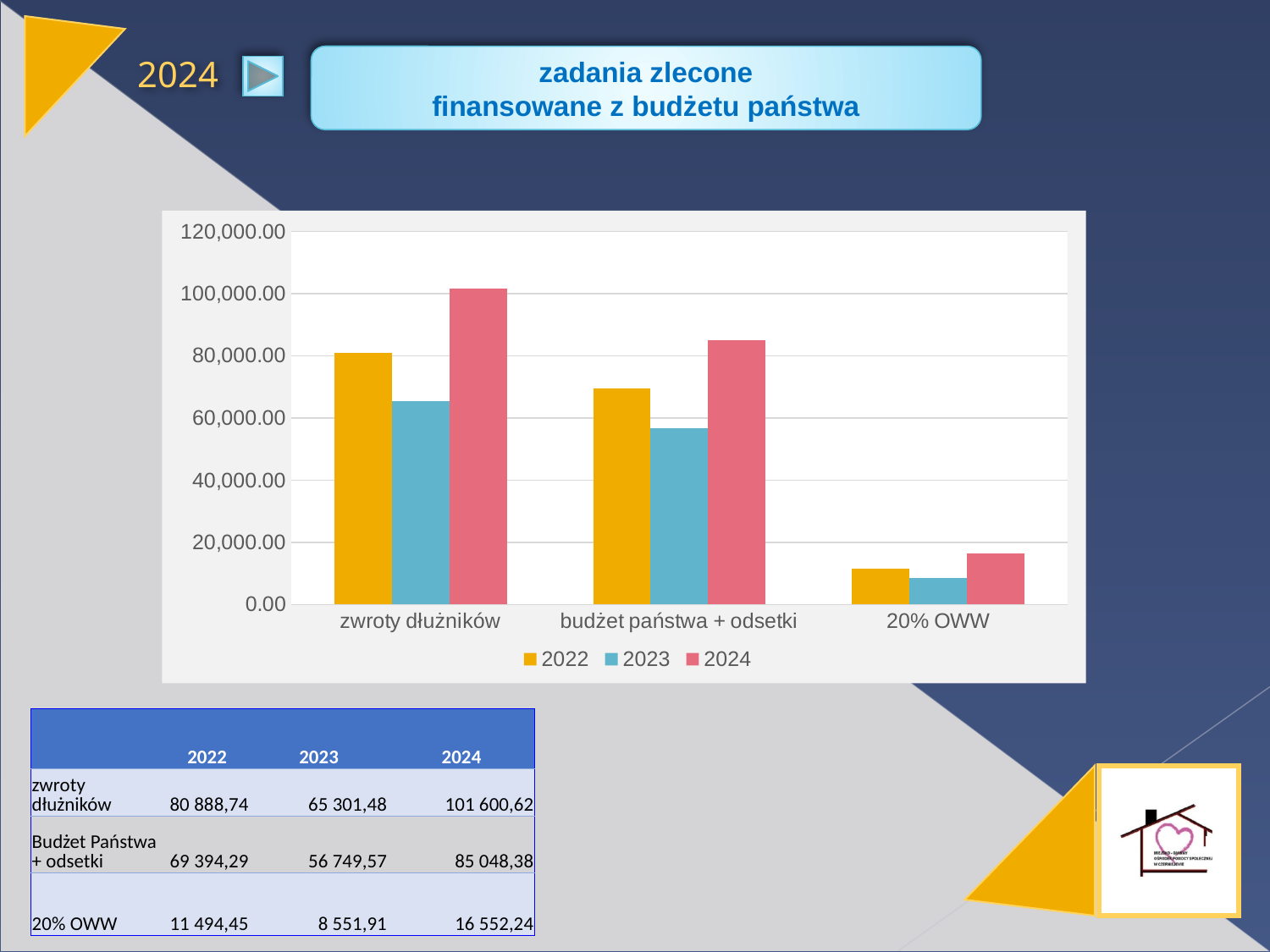
According to the table on the slide, what is the 2024 value for 20% OWW? 16 552,24 Is the 2023 value for budżet państwa + odsetki greater or less than 60,000.00? less How many categories are shown on the x axis of the chart? 3 Which series is shown in red/pink in the chart legend? 2024 What kind of chart is shown on the slide? bar chart Which category has the lowest 2023 value? 20% OWW How many series does the chart legend list? 3 Is the 2022 value for 20% OWW greater or less than 20,000.00? less According to the table on the slide, what is the 2022 value for zwroty dłużników? 80 888,74 Is the 2024 value for zwroty dłużników greater or less than 100,000.00? greater Which category has the highest 2024 value? zwroty dłużników For zwroty dłużników, which is larger: the 2022 value or the 2023 value? 2022